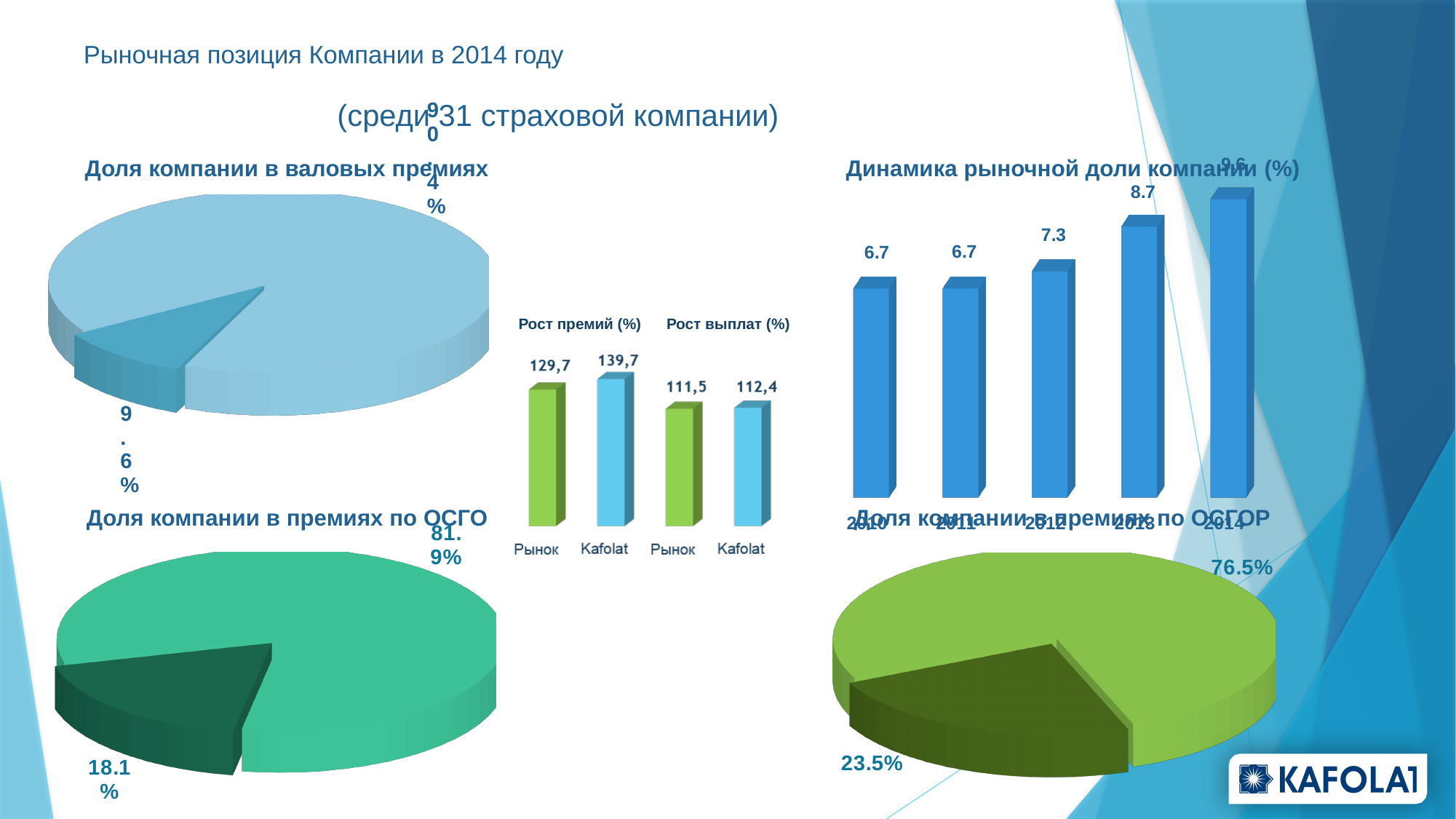
In the chart 'Динамика рыночной доли компании (%)', what is the value for 2012? 7.3 In the pie chart 'Доля компании в премиях по ОСГО', what is the share of the smaller slice? 18.1% In the chart 'Динамика рыночной доли компании (%)', what is the difference between the 2014 and 2013 values? 0.9 What kind of chart is 'Динамика рыночной доли компании (%)'? bar chart In the middle bar chart, which is larger for 'Рост премий (%)': Рынок or Kafolat? Kafolat In the chart 'Динамика рыночной доли компании (%)', which year has the highest value? 2014 In the middle bar chart, what is the 'Рост выплат (%)' value for Рынок? 111,5 In the middle bar chart, what is the 'Рост премий (%)' value for Kafolat? 139,7 In the chart 'Динамика рыночной доли компании (%)', how many years are shown? 5 In the chart 'Динамика рыночной доли компании (%)', do the values rise or fall from 2010 to 2014? rise In the pie chart 'Доля компании в премиях по ОСГОР', what is the share of the larger slice? 76.5% In the chart 'Динамика рыночной доли компании (%)', what is the value for 2014? 9.6